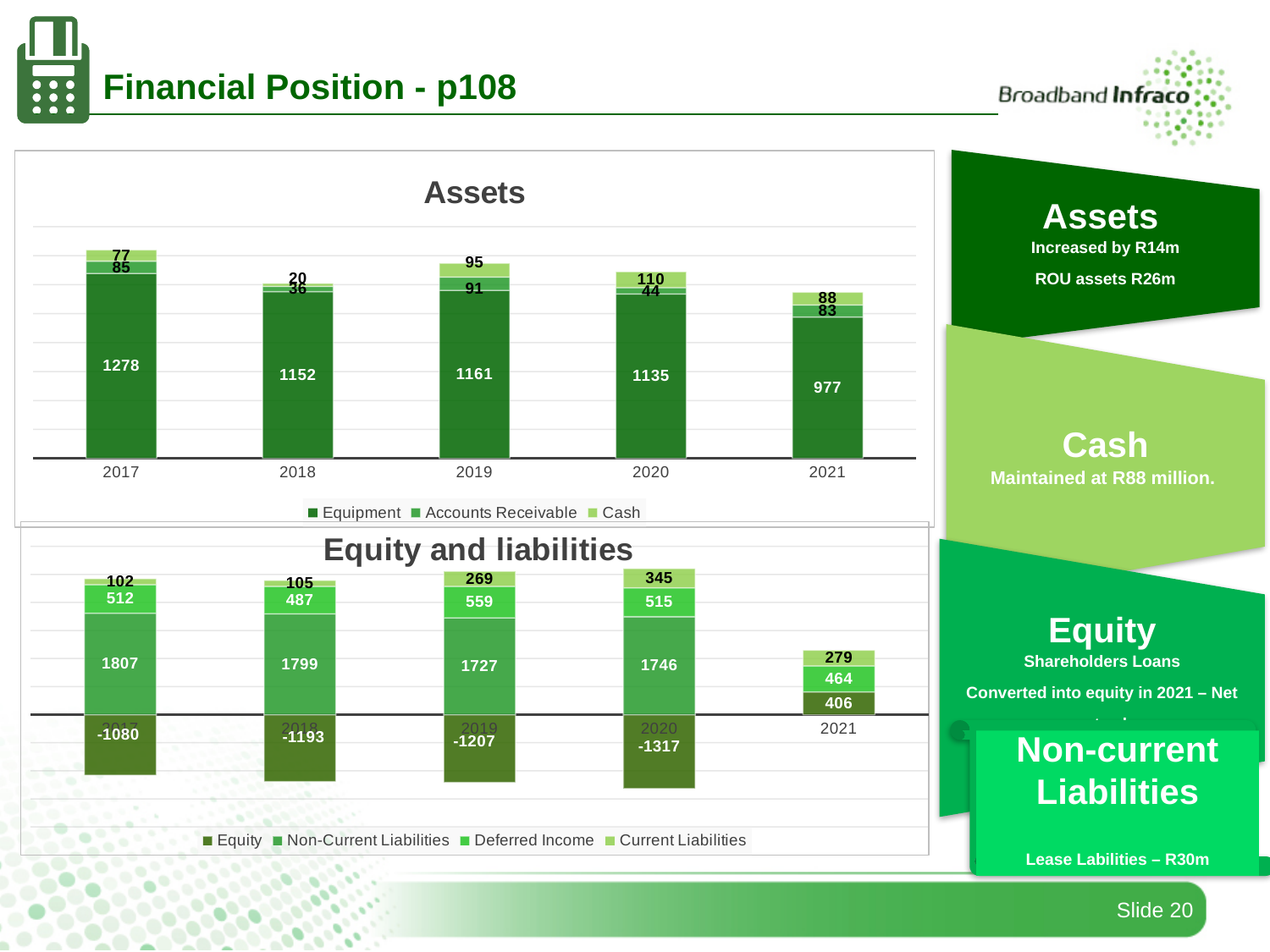
What kind of chart is the Assets chart? Stacked bar chart In the Equity and liabilities chart, what is the Equity value for 2020? -1317 How many series does the legend of the Assets chart list? 3 In the Assets chart, which year has the lowest Equipment value? 2021 How many series does the legend of the Equity and liabilities chart list? 4 In the Equity and liabilities chart, what is the Non-Current Liabilities value for 2019? 1727 In the Assets chart, what is the Equipment value for 2017? 1278 In the Assets chart, what is the Cash value for 2020? 110 In the Equity and liabilities chart, which year has the highest Current Liabilities value? 2020 In the Equity and liabilities chart, is the Deferred Income value larger in 2019 or in 2017? 2019 How many years are shown on the x axis of the Assets chart? 5 In the Assets chart, what is the difference between the Equipment values for 2017 and 2021? 301